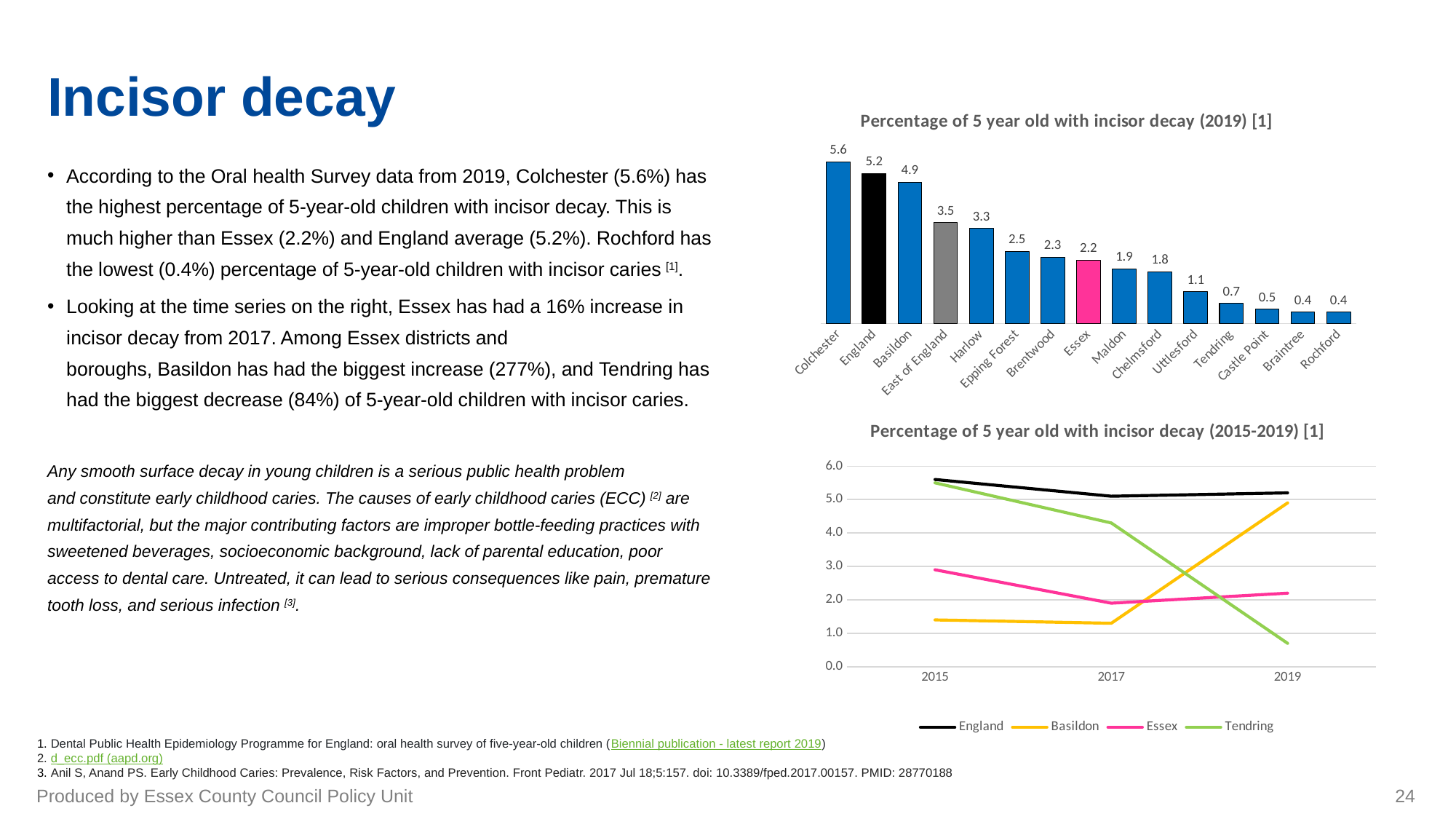
In the chart titled 'Percentage of 5 year old with incisor decay (2019)', what is the difference between the values for England and Essex? 3.0 In the chart titled 'Percentage of 5 year old with incisor decay (2015-2019)', is the value for Basildon in 2019 greater or less than 4.0? greater In the chart titled 'Percentage of 5 year old with incisor decay (2019)', which category has the highest value? Colchester In the chart titled 'Percentage of 5 year old with incisor decay (2019)', which is larger, the value for Harlow or the value for Maldon? Harlow In the chart titled 'Percentage of 5 year old with incisor decay (2019)', what is the value for Colchester? 5.6 In the chart titled 'Percentage of 5 year old with incisor decay (2019)', what colour is the bar for Essex? Pink In the chart titled 'Percentage of 5 year old with incisor decay (2019)', what is the value for East of England? 3.5 In the chart titled 'Percentage of 5 year old with incisor decay (2015-2019)', is the value for Tendring in 2019 greater or less than 1.0? less In the chart titled 'Percentage of 5 year old with incisor decay (2015-2019)', does the Tendring line rise or fall from 2015 to 2019? Fall What kind of chart is the chart titled 'Percentage of 5 year old with incisor decay (2019)'? Bar chart How many series does the legend list in the chart titled 'Percentage of 5 year old with incisor decay (2015-2019)'? 4 How many categories are shown in the chart titled 'Percentage of 5 year old with incisor decay (2019)'? 15